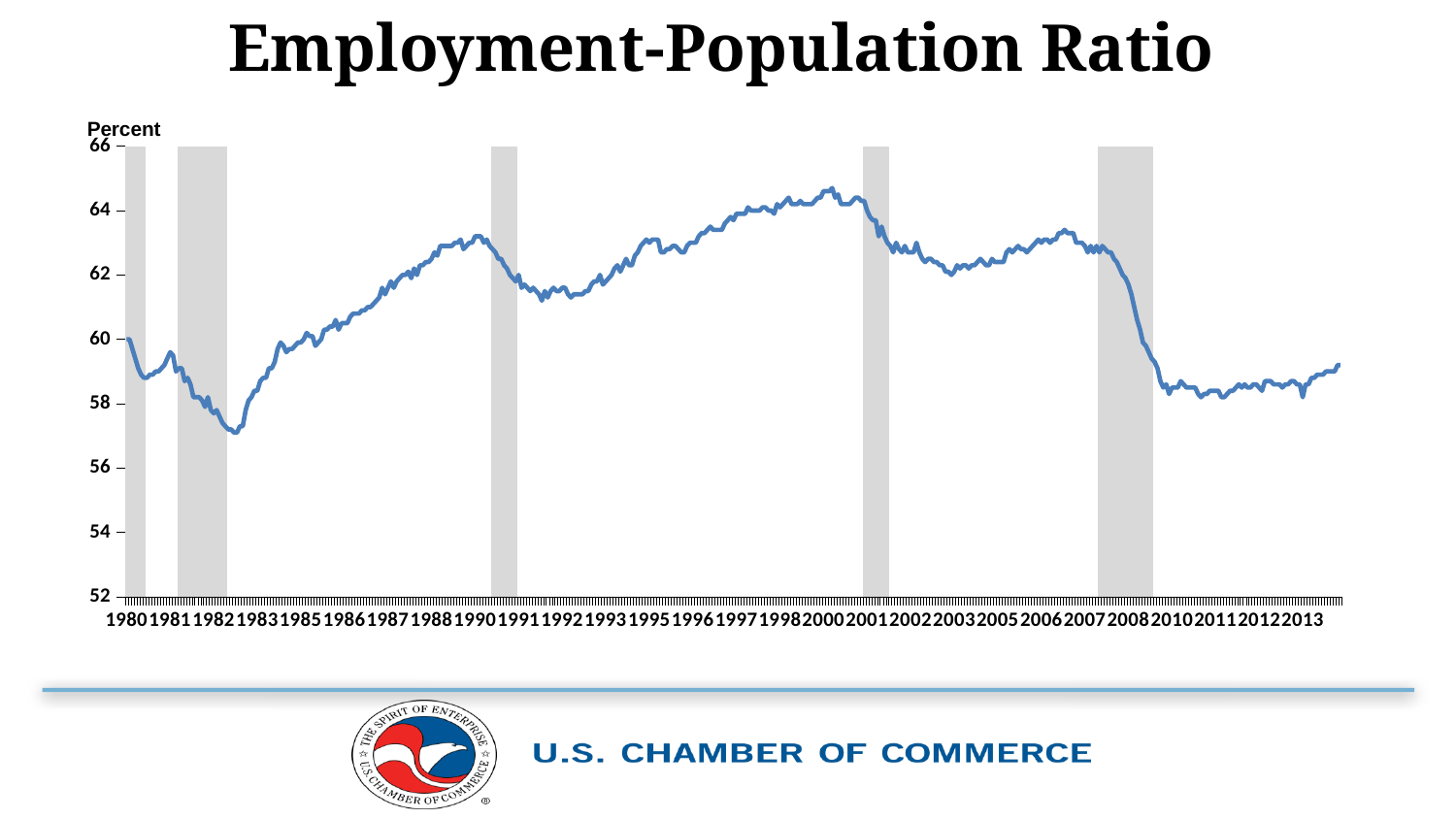
Is the value of the employment-population ratio in 2013 greater or less than 60? less Is the value of the employment-population ratio in 1990 greater or less than 62? greater Is the value of the employment-population ratio at its peak around 2000 greater or less than 64? greater Does the employment-population ratio rise or fall between 1983 and 1990? rise How many lines (data series) are plotted on the chart? 1 What is the title of the chart? Employment-Population Ratio What kind of chart is shown on the slide? line chart What unit is shown on the vertical axis of the chart? Percent Around which year does the employment-population ratio reach its highest point on the chart? 2000 Does the employment-population ratio rise or fall between 2008 and 2010? fall